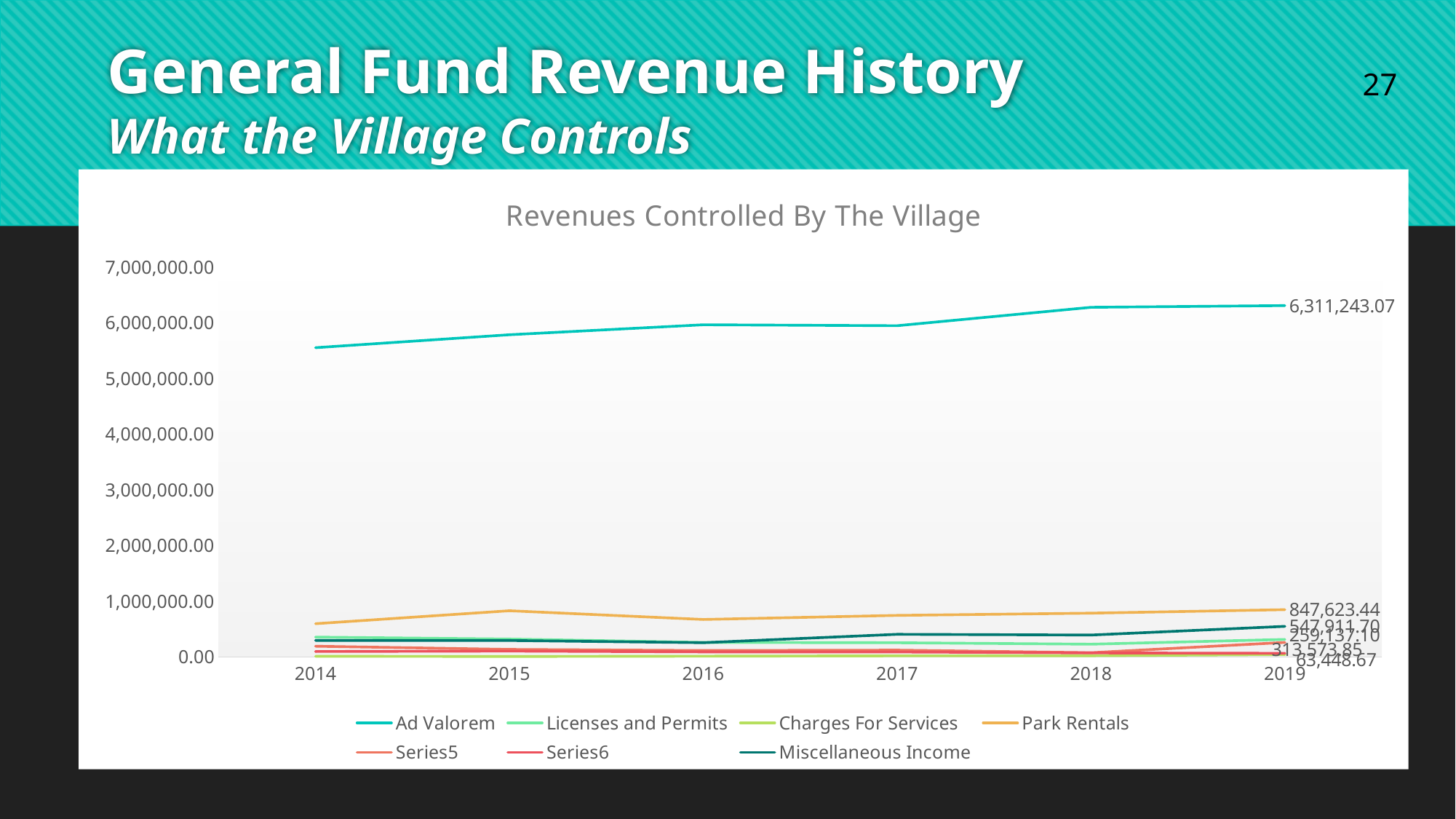
What kind of chart is shown on the slide? Line chart What is the title of the chart? Revenues Controlled By The Village How many years are shown on the x axis? 6 What is the Ad Valorem value for 2019? 6,311,243.07 What is the Miscellaneous Income value for 2019? 547,911.70 Is the Ad Valorem value for 2014 greater or less than 5,000,000.00? greater What is the Park Rentals value for 2019? 847,623.44 Which is larger in 2019, Park Rentals or Miscellaneous Income? Park Rentals Which series has the highest value in 2019? Ad Valorem What is the difference between the Ad Valorem and Park Rentals values in 2019? 5,463,619.63 How many series does the legend list? 7 Does the Ad Valorem line rise or fall from 2014 to 2019? rise